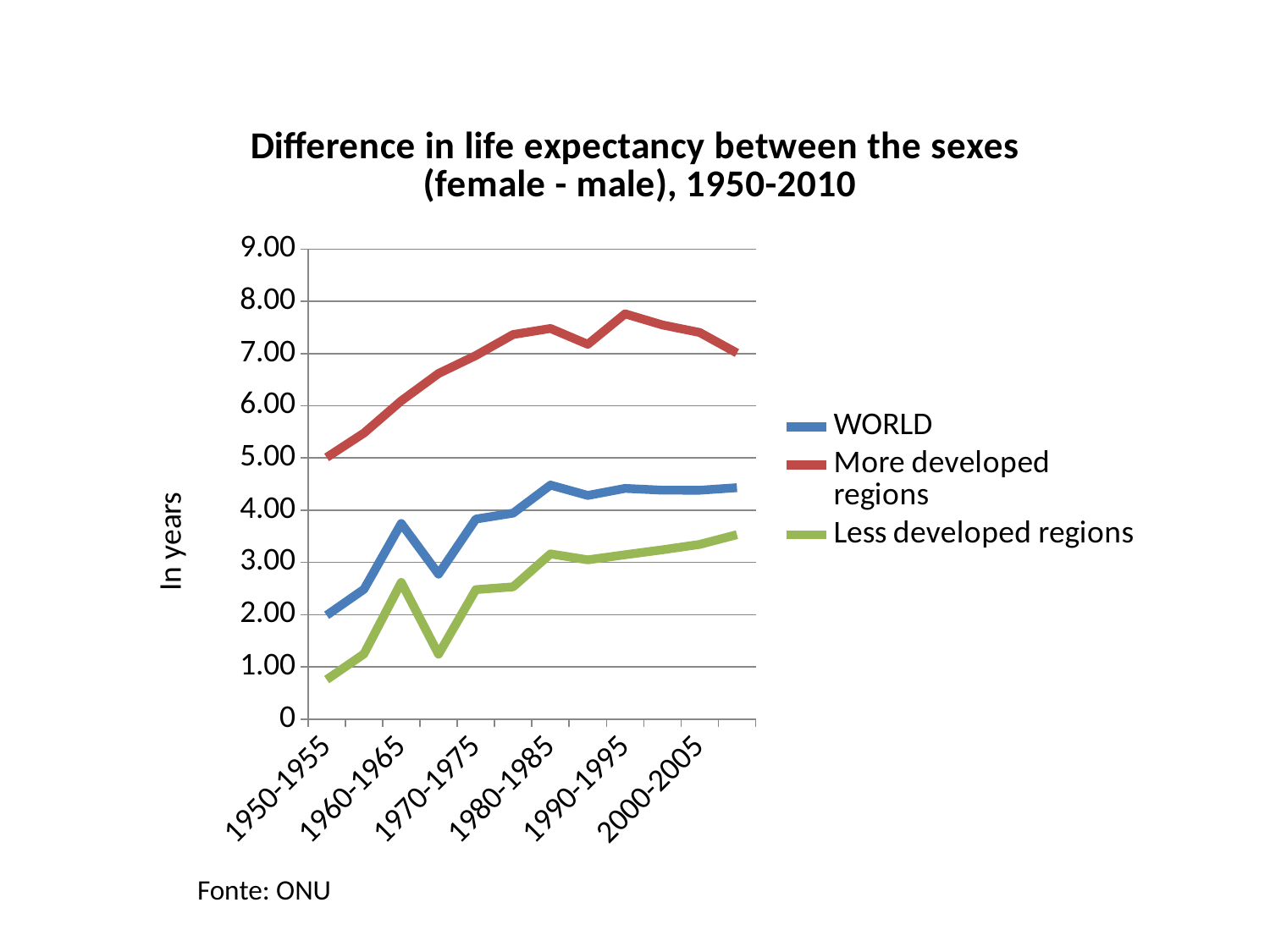
In 1970-1975, which is larger: the value for WORLD or the value for Less developed regions? WORLD Is the value for More developed regions in 1970-1975 greater or less than 6.00? greater How many series does the legend list? 3 What kind of chart is shown on the slide? line chart Is the value for WORLD in 1990-1995 greater or less than 4.00? greater Which series has the highest values throughout the chart? More developed regions Is the value for Less developed regions in 1950-1955 greater or less than 1.00? less Which series has the lowest values throughout the chart? Less developed regions What is the label of the vertical axis? In years Does the WORLD series generally rise or fall from 1950-1955 to the end of the period? rise